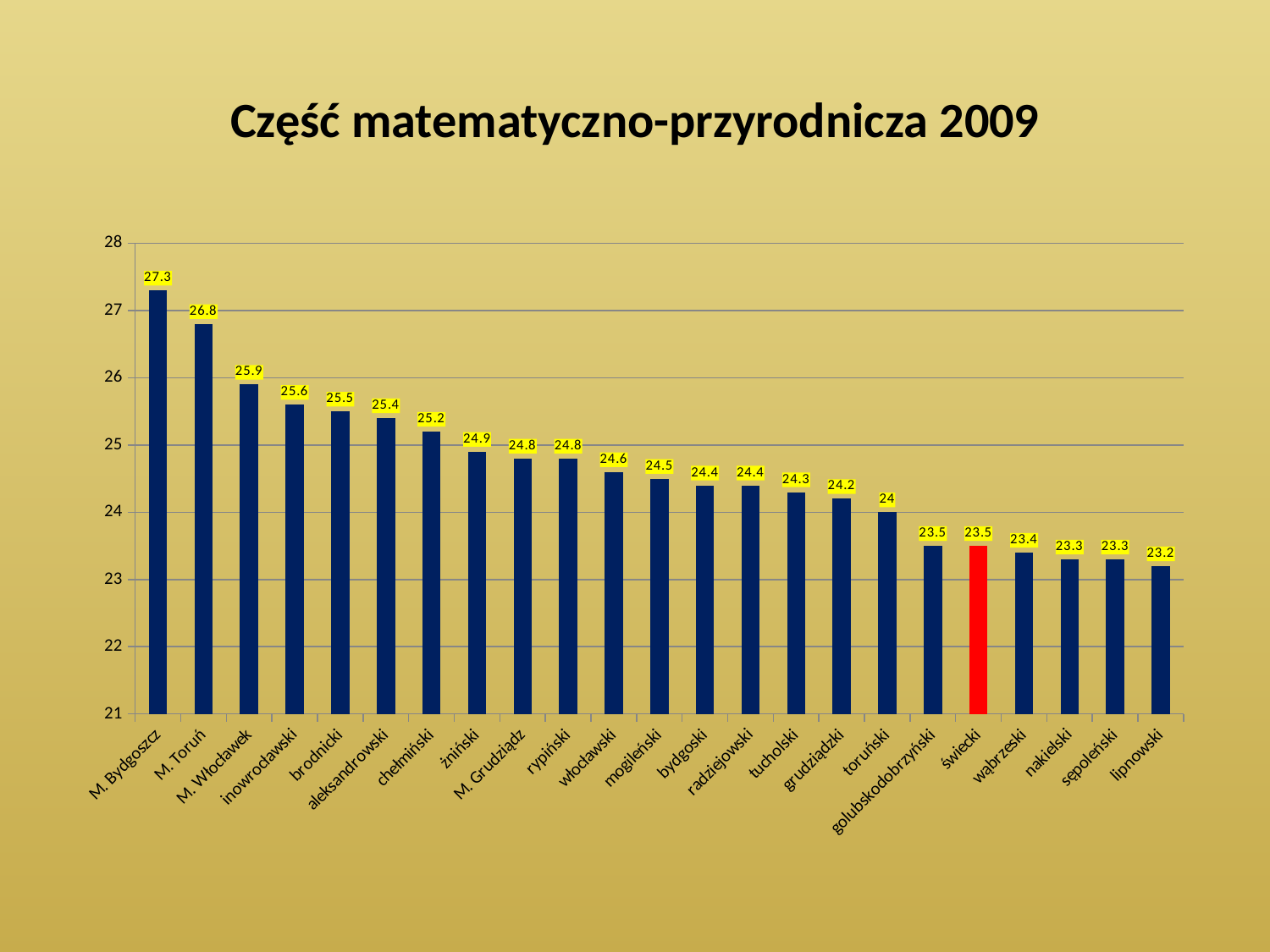
What is the value for M. Bydgoszcz? 27.3 What is the value for toruński? 24 How many categories are shown on the x axis? 23 Which is larger, the value for brodnicki or the value for chełmiński? brodnicki Which category has the highest value? M. Bydgoszcz What kind of chart is shown on the slide? bar chart What is the difference between the values for M. Toruń and M. Włocławek? 0.9 What is the difference between the values for M. Bydgoszcz and lipnowski? 4.1 Which bar is coloured red instead of dark blue? świecki Is the value for inowrocławski greater or less than 25? greater Which category has the lowest value? lipnowski What is the value for świecki? 23.5